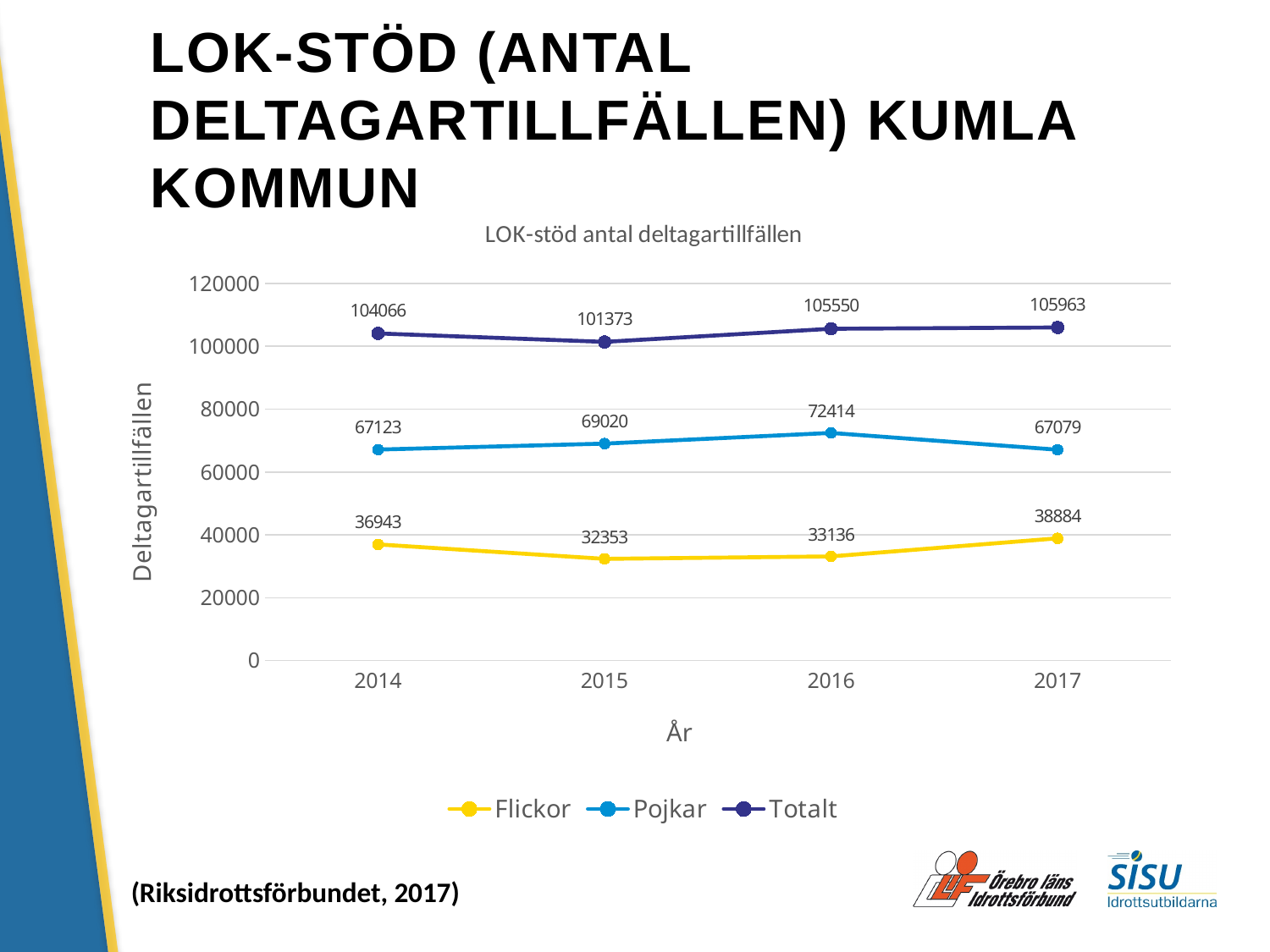
What is the value for Totalt in 2017? 105963 Does the Totalt series rise or fall from 2015 to 2017? Rise What is the value for Pojkar in 2016? 72414 What is the difference between the Flickor values in 2017 and 2015? 6531 In which year is the Totalt value lowest? 2015 What type of chart is shown on the slide? Line chart How many series does the legend list? 3 Which is larger, the Pojkar value in 2014 or in 2017? 2014 What is the label of the y axis? Deltagartillfällen In which year is the Pojkar value highest? 2016 What is the value for Flickor in 2015? 32353 How many years are plotted on the x axis? 4